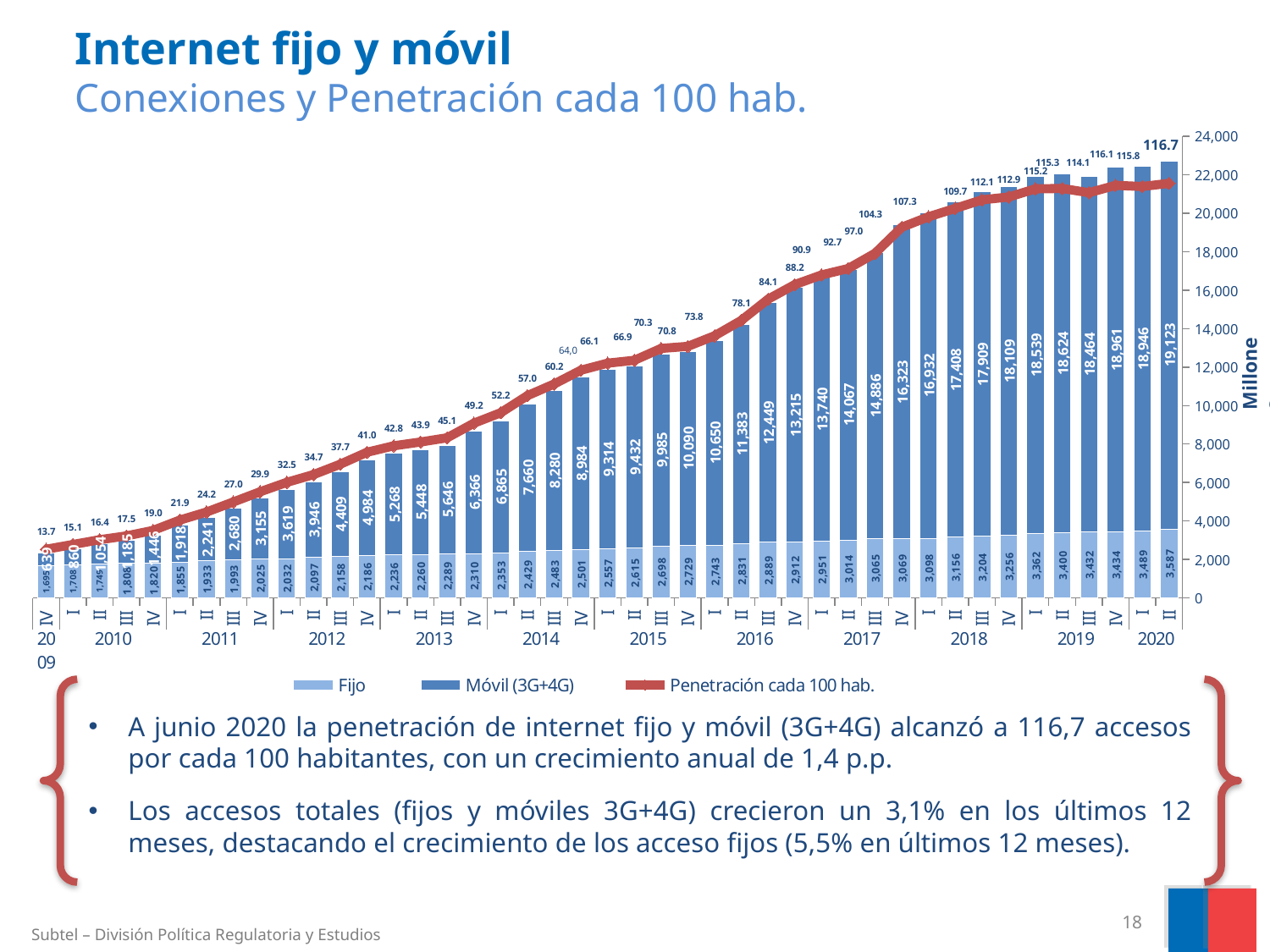
In which quarter is Penetración cada 100 hab. lowest? IV 2009 What is the value of Penetración cada 100 hab. for II 2020? 116.7 What is the difference between the Móvil (3G+4G) values for II 2020 and I 2020? 177 What is the total of the stacked bar for II 2020 (Fijo plus Móvil)? 22,710 What kind of chart is shown on the slide? Bar chart (stacked bars with a line overlay) What is the Fijo value for II 2020? 3,587 Does Penetración cada 100 hab. generally rise or fall from IV 2009 to II 2020? Rise In which quarter is Penetración cada 100 hab. highest? II 2020 Which is larger, the Móvil (3G+4G) value for III 2019 or for IV 2019? IV 2019 What is the Móvil (3G+4G) value for II 2020? 19,123 How many series does the legend list? 3 What is the Fijo value for I 2019? 3,362